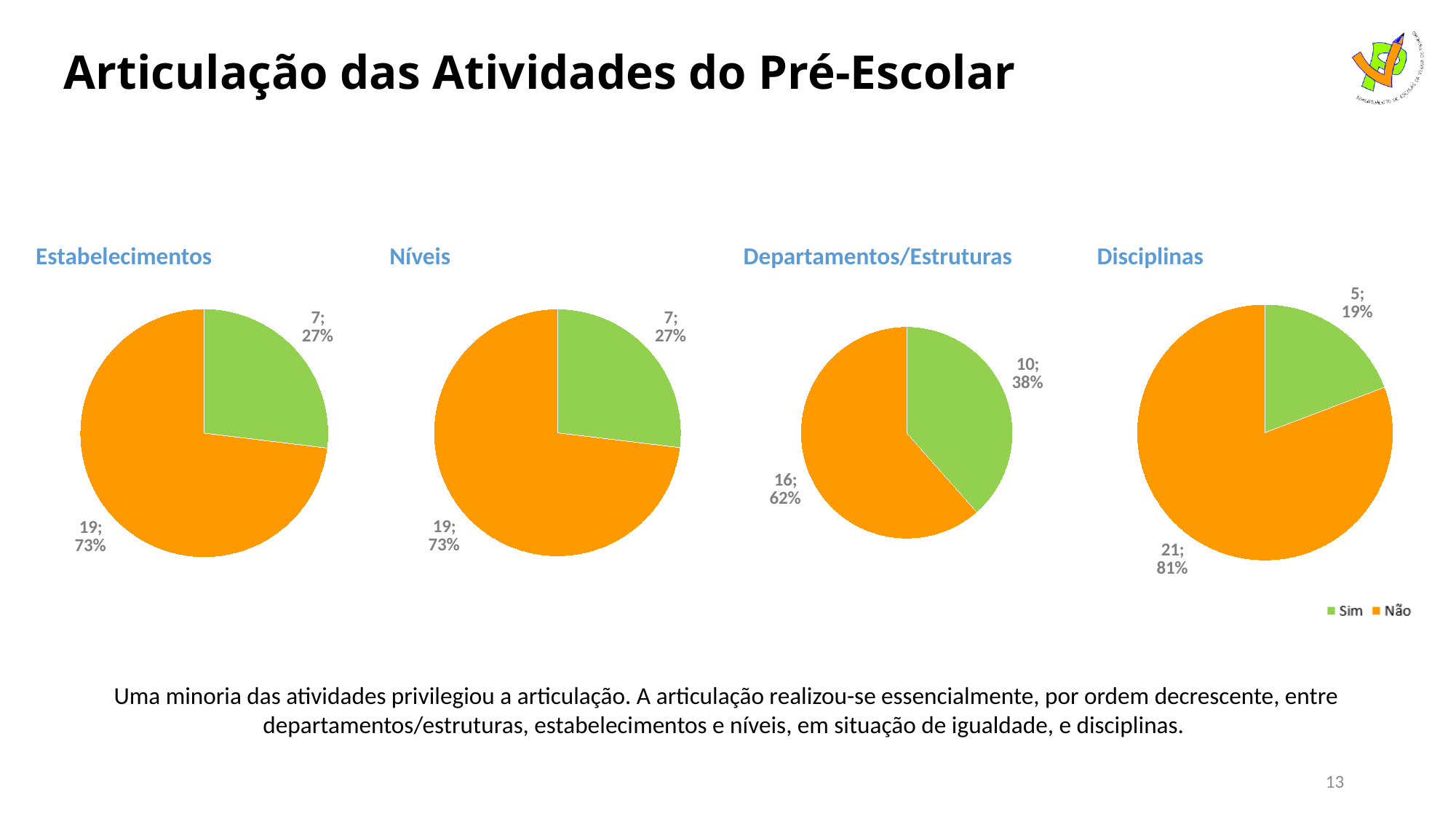
In the 'Níveis' pie chart, what is the value for 'Não'? 19 What kind of chart is used for the 'Estabelecimentos' data? pie chart In the 'Níveis' pie chart, what share of the pie is 'Sim'? 27% In the 'Departamentos/Estruturas' pie chart, what is the value for 'Sim'? 10 In the 'Estabelecimentos' pie chart, what is the value for 'Sim'? 7 In the 'Estabelecimentos' pie chart, what share of the pie is 'Não'? 73% In the 'Departamentos/Estruturas' pie chart, what share of the pie is 'Não'? 62% In the 'Disciplinas' pie chart, which slice is larger, 'Sim' or 'Não'? Não In the 'Disciplinas' pie chart, what is the value for 'Não'? 21 In the 'Departamentos/Estruturas' pie chart, what is the difference between the 'Não' and 'Sim' values? 6 How many series does the legend list? 2